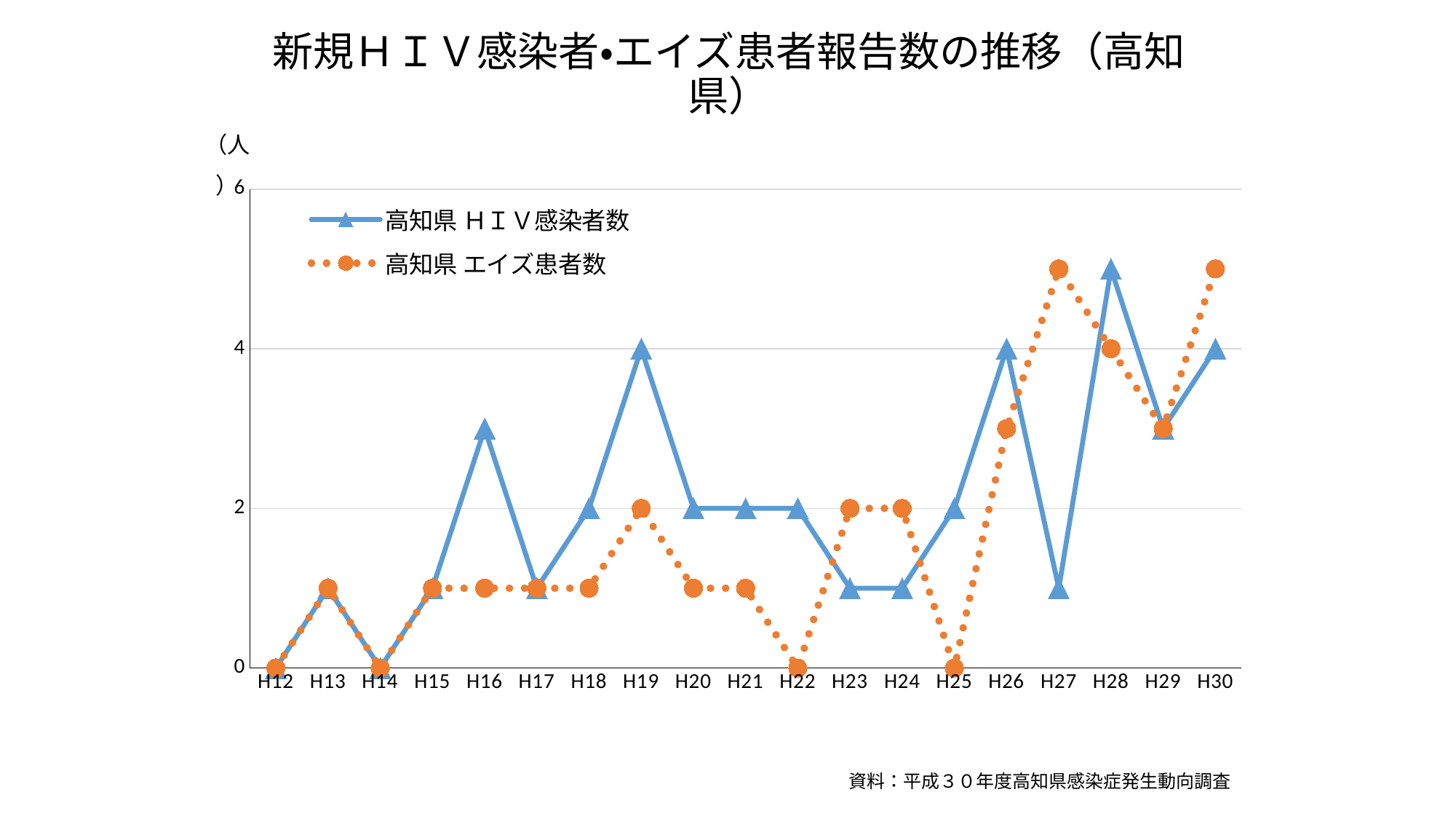
What kind of chart is shown on the slide? line chart Does 高知県 ＨＩＶ感染者数 rise or fall from H26 to H27? fall What is the value of 高知県 エイズ患者数 in H22? 0 In H27, which series has the larger value, 高知県 ＨＩＶ感染者数 or 高知県 エイズ患者数? 高知県 エイズ患者数 What is the value of 高知県 ＨＩＶ感染者数 in H19? 4 What is the value of 高知県 エイズ患者数 in H28? 4 What is the source cited below the chart? 平成３０年度高知県感染症発生動向調査 In which year is 高知県 ＨＩＶ感染者数 highest? H28 What is the difference between 高知県 ＨＩＶ感染者数 in H19 and in H18? 2 How many series does the legend list? 2 Is the value for 高知県 ＨＩＶ感染者数 in H28 greater or less than 4? greater How many years (categories) are plotted along the x axis? 19